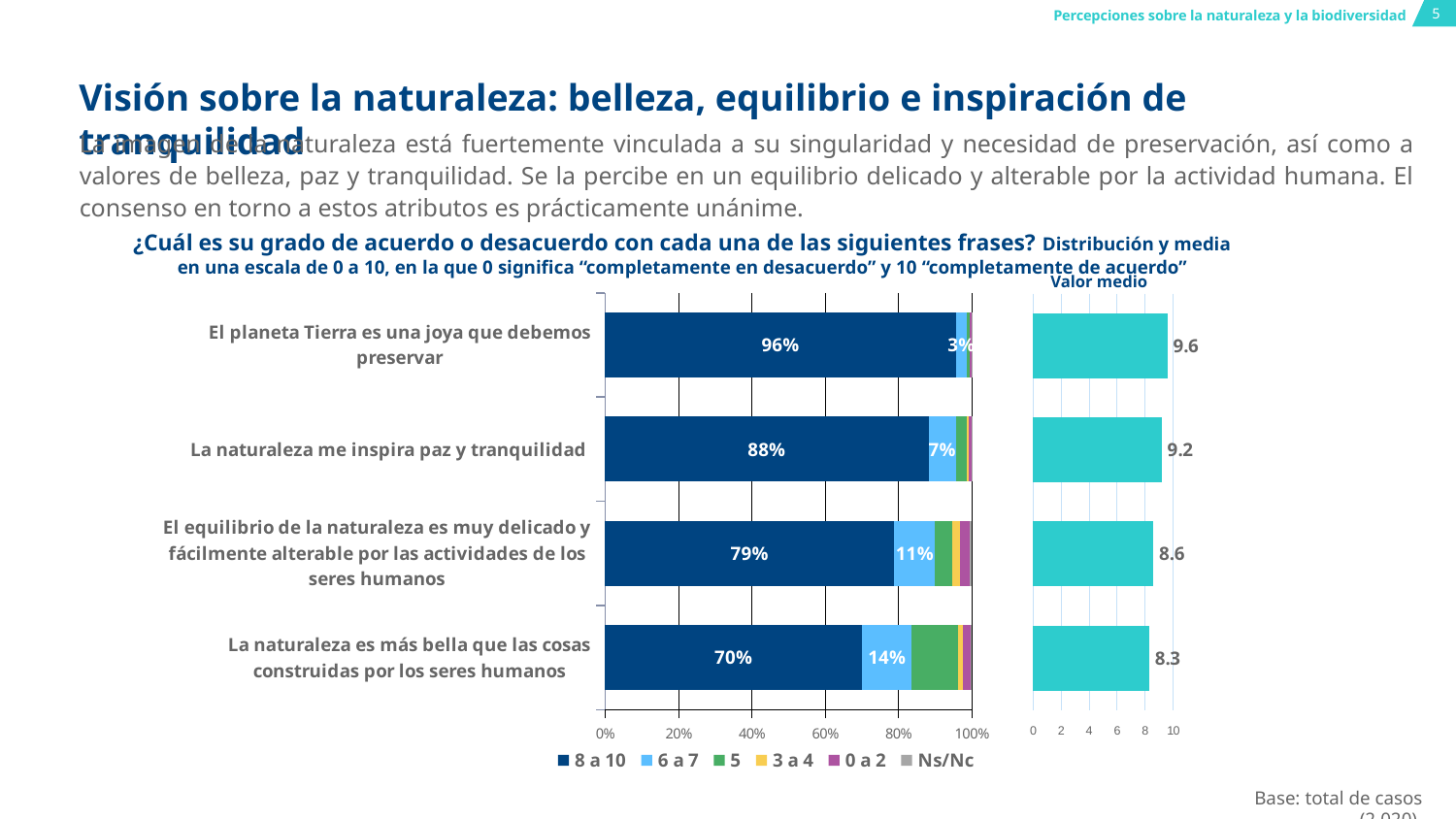
In the "Valor medio" chart, what is the difference between the mean values for "El planeta Tierra es una joya que debemos preservar" and "La naturaleza es más bella que las cosas construidas por los seres humanos"? 1.3 In the stacked bar chart, which statement has a larger 6 a 7 share: "El equilibrio de la naturaleza es muy delicado..." or "La naturaleza me inspira paz y tranquilidad"? El equilibrio de la naturaleza es muy delicado y fácilmente alterable por las actividades de los seres humanos In the "Valor medio" chart, which statement has the lowest mean value? La naturaleza es más bella que las cosas construidas por los seres humanos In the "Valor medio" chart, is the mean value for "El equilibrio de la naturaleza es muy delicado..." greater or less than 8? greater In the stacked bar chart, what is the difference between the 8 a 10 percentages for "La naturaleza me inspira paz y tranquilidad" and "El equilibrio de la naturaleza es muy delicado y fácilmente alterable por las actividades de los seres humanos"? 9% In the "Valor medio" chart, what is the mean value for "La naturaleza me inspira paz y tranquilidad"? 9.2 What kind of chart is the "Valor medio" chart? Bar chart In the "Valor medio" chart, which statement has the highest mean value? El planeta Tierra es una joya que debemos preservar In the stacked bar chart, what percentage gave a score of 6 a 7 to "La naturaleza es más bella que las cosas construidas por los seres humanos"? 14% In the stacked bar chart, what percentage of respondents gave a score of 8 a 10 to "El planeta Tierra es una joya que debemos preservar"? 96% How many statements are shown in the stacked bar chart? 4 How many series does the legend of the stacked bar chart list? 6